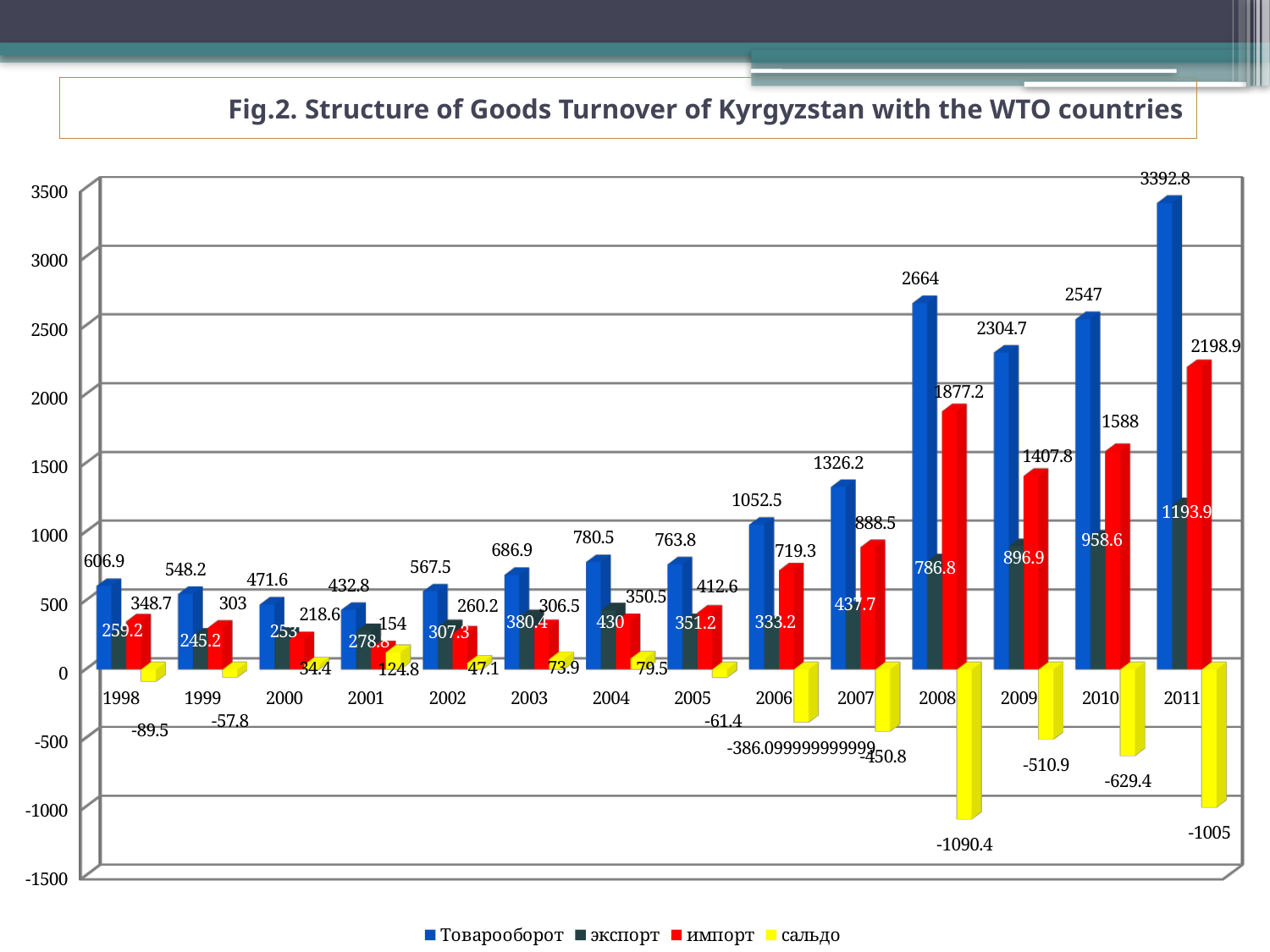
What is the value of импорт for 2008? 1877.2 What is the difference between Товарооборот in 2008 and in 2009? 359.3 Which series is shown in yellow in the legend? сальдо What is the value of сальдо for 2001? 124.8 What is the value of экспорт for 2010? 958.6 How many series does the legend list? 4 What is the value of Товарооборот for 2011? 3392.8 Which is larger in 2005, экспорт or импорт? импорт How many years are shown on the x axis? 14 In which year is сальдо lowest? 2008 What kind of chart is shown on the slide? bar chart In which year is Товарооборот highest? 2011